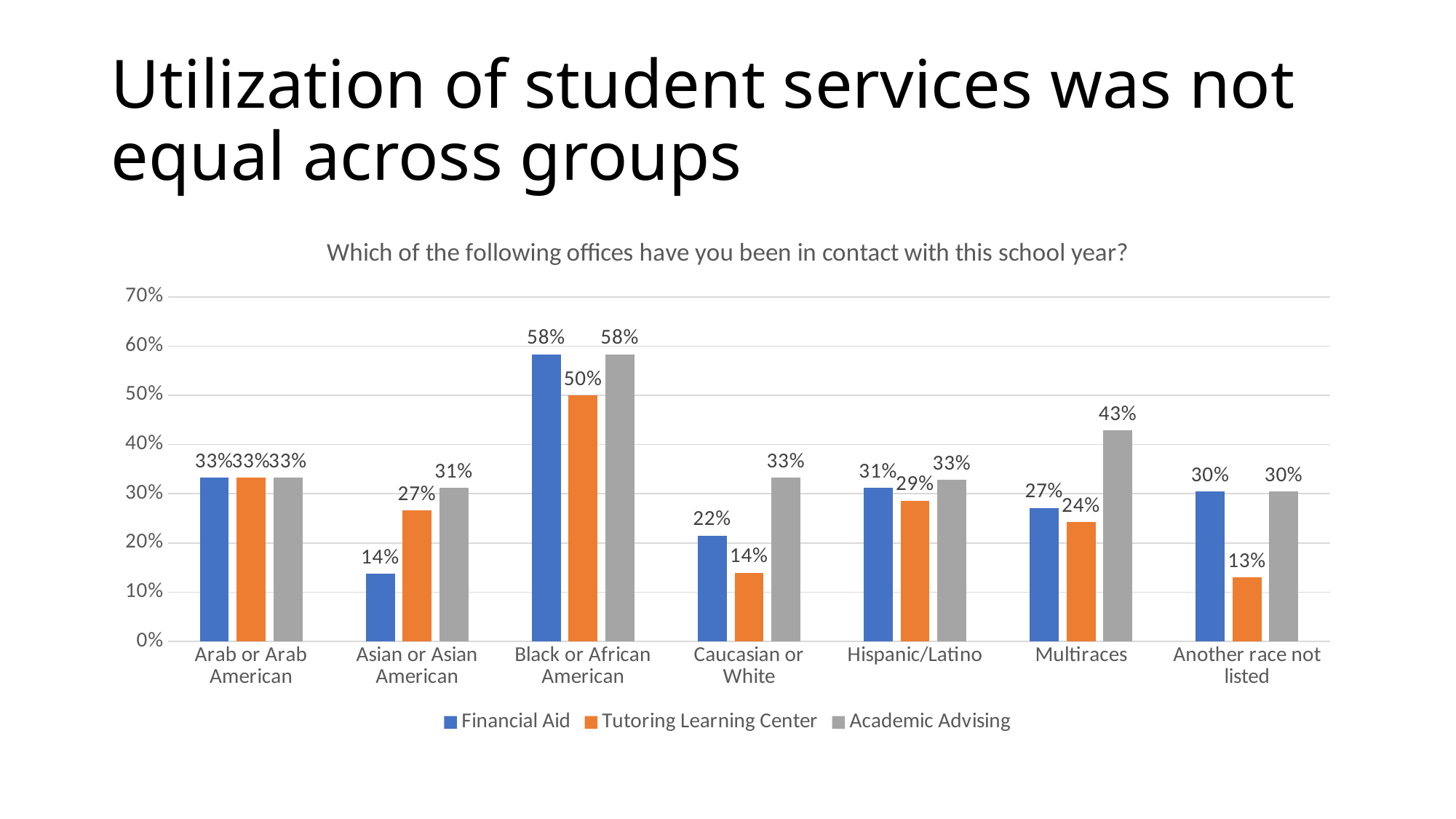
What kind of chart is shown on the slide? bar chart What is the Financial Aid value for Black or African American? 58% Which category has the lowest Financial Aid value? Asian or Asian American What is the title of the chart? Which of the following offices have you been in contact with this school year? How many categories are shown on the x axis? 7 What is the Academic Advising value for Multiraces? 43% What is the Tutoring Learning Center value for Another race not listed? 13% What is the difference between the Academic Advising value and the Tutoring Learning Center value for Multiraces? 19% Is the Tutoring Learning Center value for Black or African American greater or less than 40%? greater Which category has the highest Tutoring Learning Center value? Black or African American How many series does the legend list? 3 Which is larger for Caucasian or White: the Financial Aid value or the Academic Advising value? Academic Advising